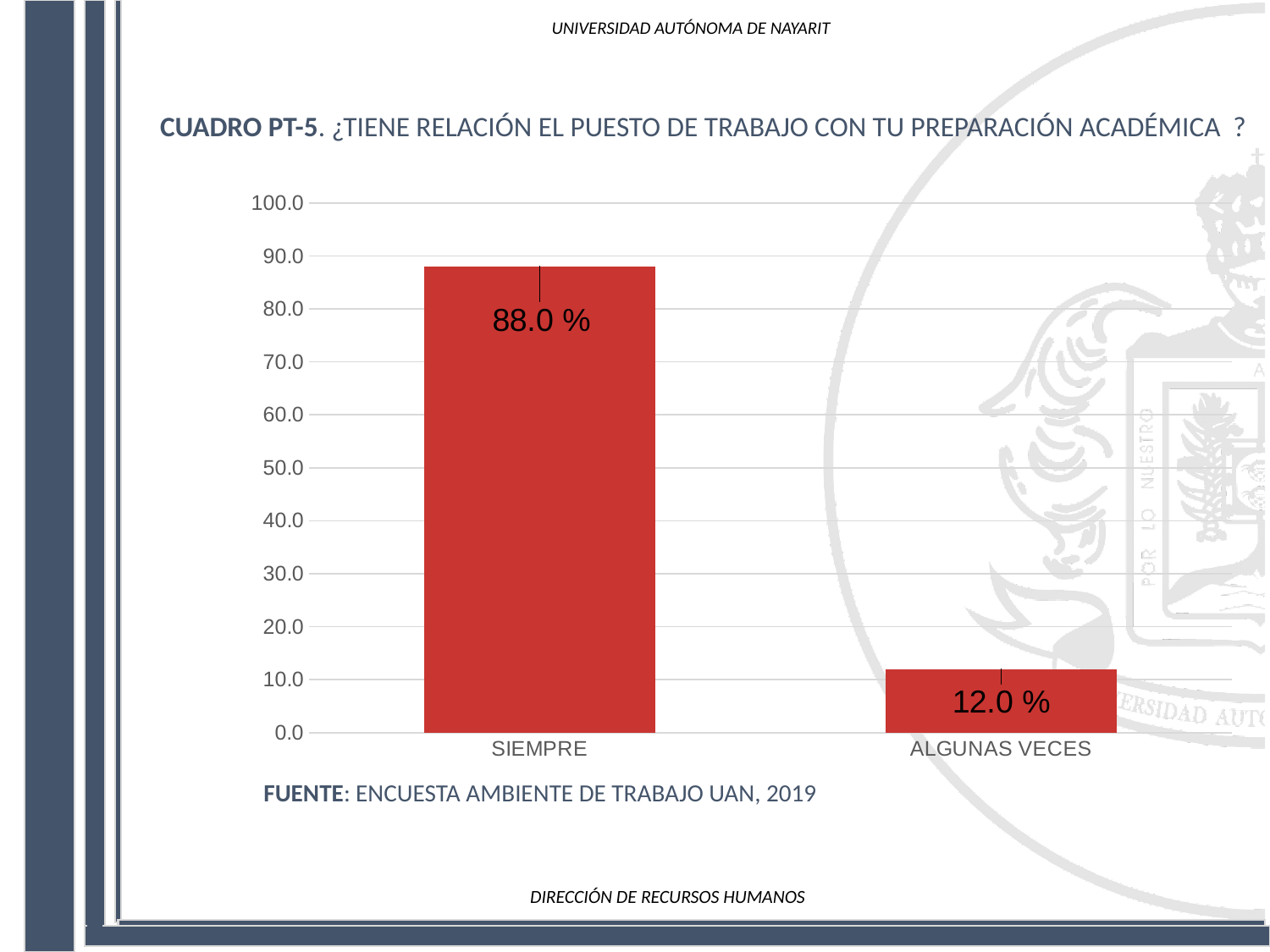
Is the value for ALGUNAS VECES greater or less than 20.0? less What is the value for ALGUNAS VECES? 12.0 % What is the source cited below the chart? ENCUESTA AMBIENTE DE TRABAJO UAN, 2019 What colour are the bars in the chart? red How many categories are shown on the chart? 2 Which category has the highest value? SIEMPRE What is the value for SIEMPRE? 88.0 % Which category has the lowest value? ALGUNAS VECES Which is larger, the value for SIEMPRE or the value for ALGUNAS VECES? SIEMPRE Is the value for SIEMPRE greater or less than 80.0? greater What is the difference between the values for SIEMPRE and ALGUNAS VECES? 76.0 % What kind of chart is shown on the slide? bar chart